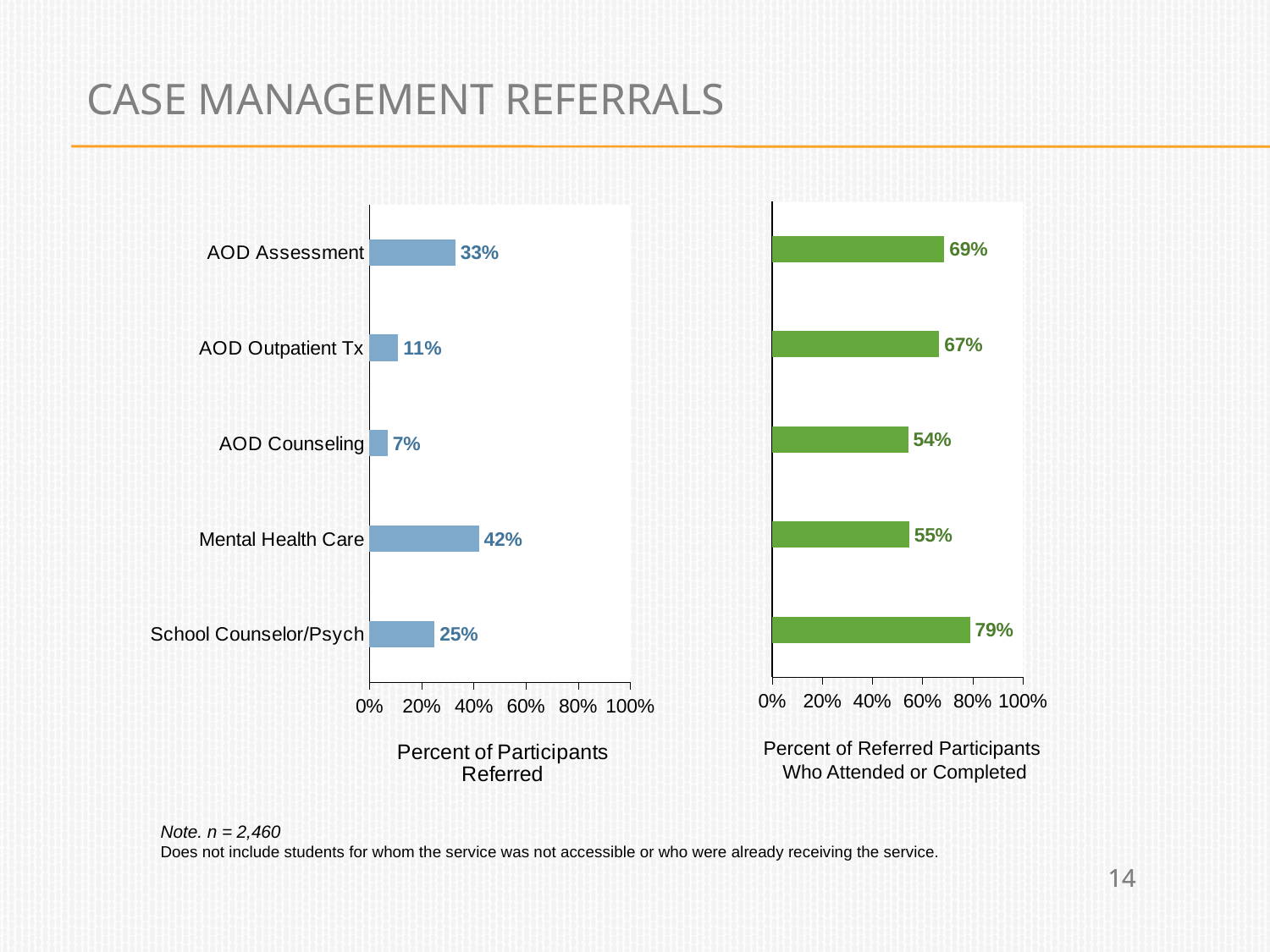
In the 'Percent of Referred Participants Who Attended or Completed' chart, which category has the highest value? School Counselor/Psych In the 'Percent of Referred Participants Who Attended or Completed' chart, what is the value for School Counselor/Psych? 79% In the 'Percent of Participants Referred' chart, what is the value for Mental Health Care? 42% In the 'Percent of Referred Participants Who Attended or Completed' chart, which category has the lowest value? AOD Counseling In the 'Percent of Participants Referred' chart, which category has the highest value? Mental Health Care In the 'Percent of Participants Referred' chart, is the value for School Counselor/Psych greater or less than 40%? less How many categories are shown in the 'Percent of Participants Referred' chart? 5 In the 'Percent of Referred Participants Who Attended or Completed' chart, which is larger: AOD Assessment or AOD Counseling? AOD Assessment What type of chart is the 'Percent of Participants Referred' chart? Bar chart In the 'Percent of Participants Referred' chart, what is the difference between AOD Assessment and AOD Outpatient Tx? 22% In the 'Percent of Participants Referred' chart, which category has the lowest value? AOD Counseling In the 'Percent of Referred Participants Who Attended or Completed' chart, what is the difference between School Counselor/Psych and Mental Health Care? 24%